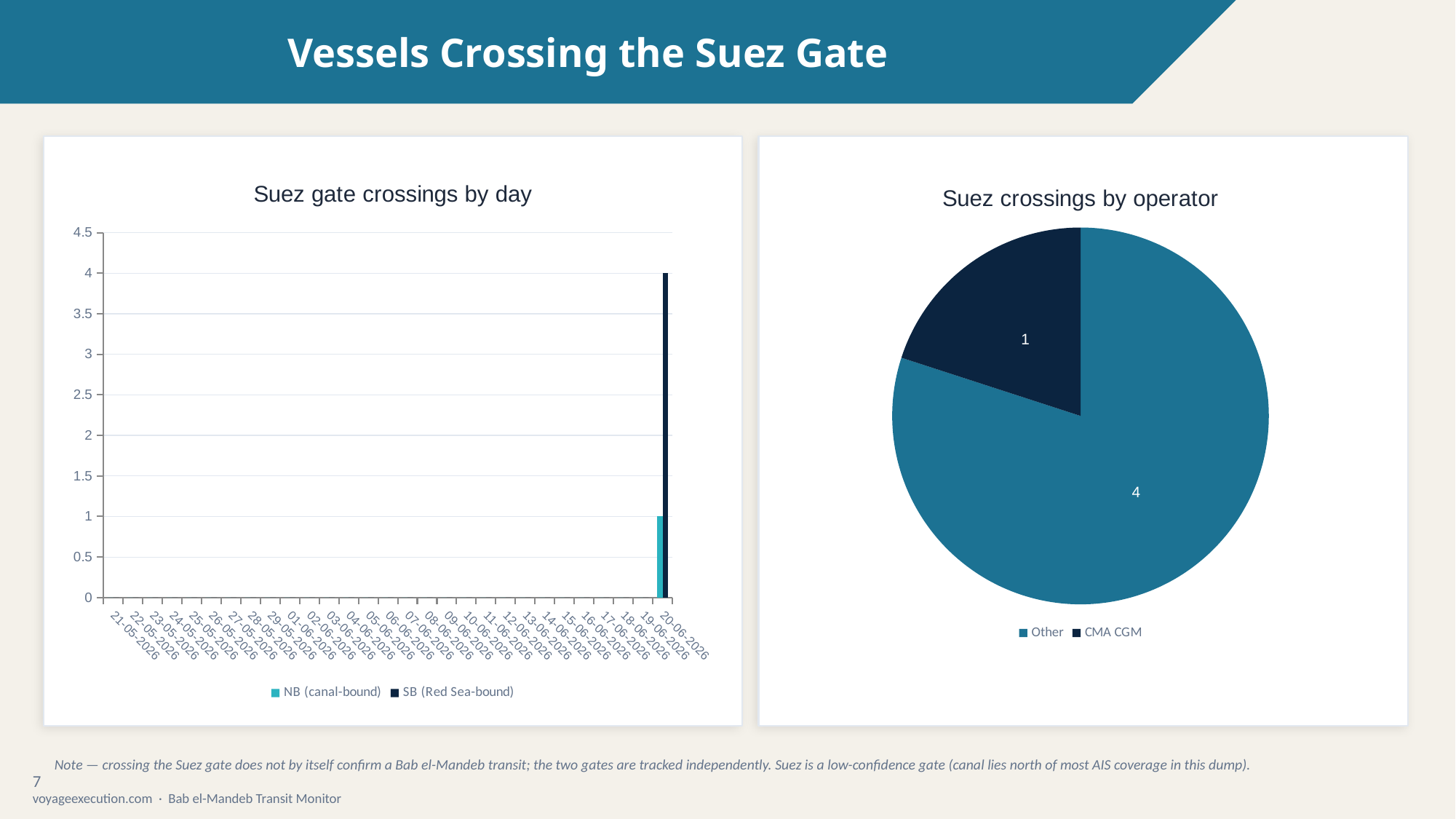
In "Suez gate crossings by day", how many series does the legend list? 2 In "Suez crossings by operator", what is the value for Other? 4 In "Suez crossings by operator", what share of the pie does Other represent? 80% In "Suez gate crossings by day", what is the value for NB (canal-bound) on 20-06-2026? 1 What kind of chart is "Suez crossings by operator"? Pie chart What kind of chart is "Suez gate crossings by day"? Bar chart In "Suez crossings by operator", what is the difference between Other and CMA CGM? 3 In "Suez crossings by operator", what is the value for CMA CGM? 1 In "Suez crossings by operator", which operator has the largest slice? Other In "Suez gate crossings by day", is the value for SB (Red Sea-bound) on 20-06-2026 greater or less than 3? greater In "Suez gate crossings by day", what is the value for SB (Red Sea-bound) on 20-06-2026? 4 In "Suez gate crossings by day", what are the two legend entries? NB (canal-bound) and SB (Red Sea-bound)